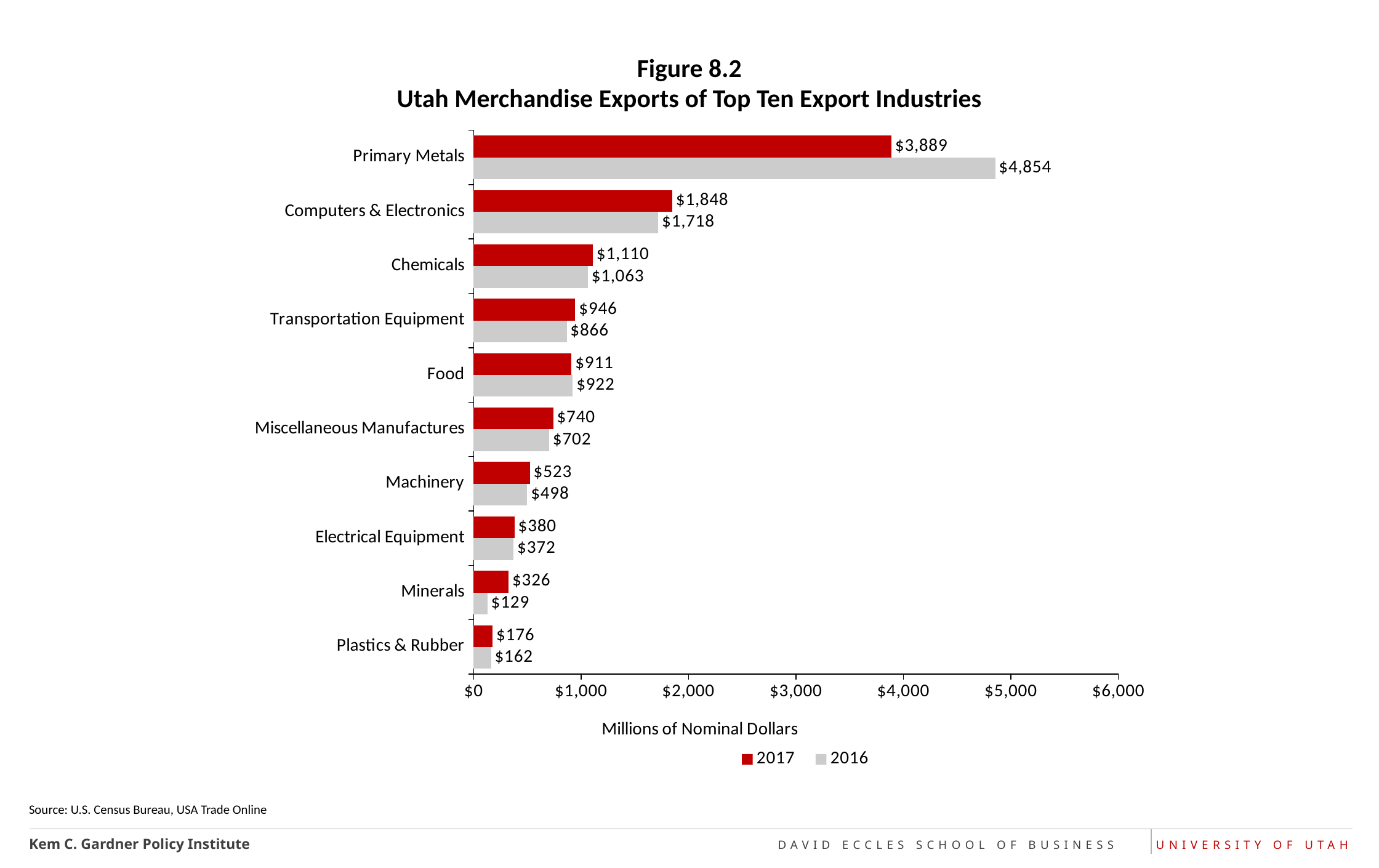
How many series does the legend list? 2 What is the difference between the 2017 and 2016 export values for Minerals? $197 By how much did Primary Metals exports fall from 2016 to 2017? $965 What type of chart is shown on the slide? Bar chart Which industry had the highest export value in 2017? Primary Metals Were Food exports larger in 2017 or 2016? 2016 What was the value of Computers & Electronics exports in 2016? $1,718 How many export industries are shown on the chart? 10 What was the value of Utah's Primary Metals exports in 2017? $3,889 Which industry had the lowest export value in 2016? Minerals Is the 2017 value for Chemicals greater or less than $1,000? greater What was the value of Utah's Minerals exports in 2016? $129